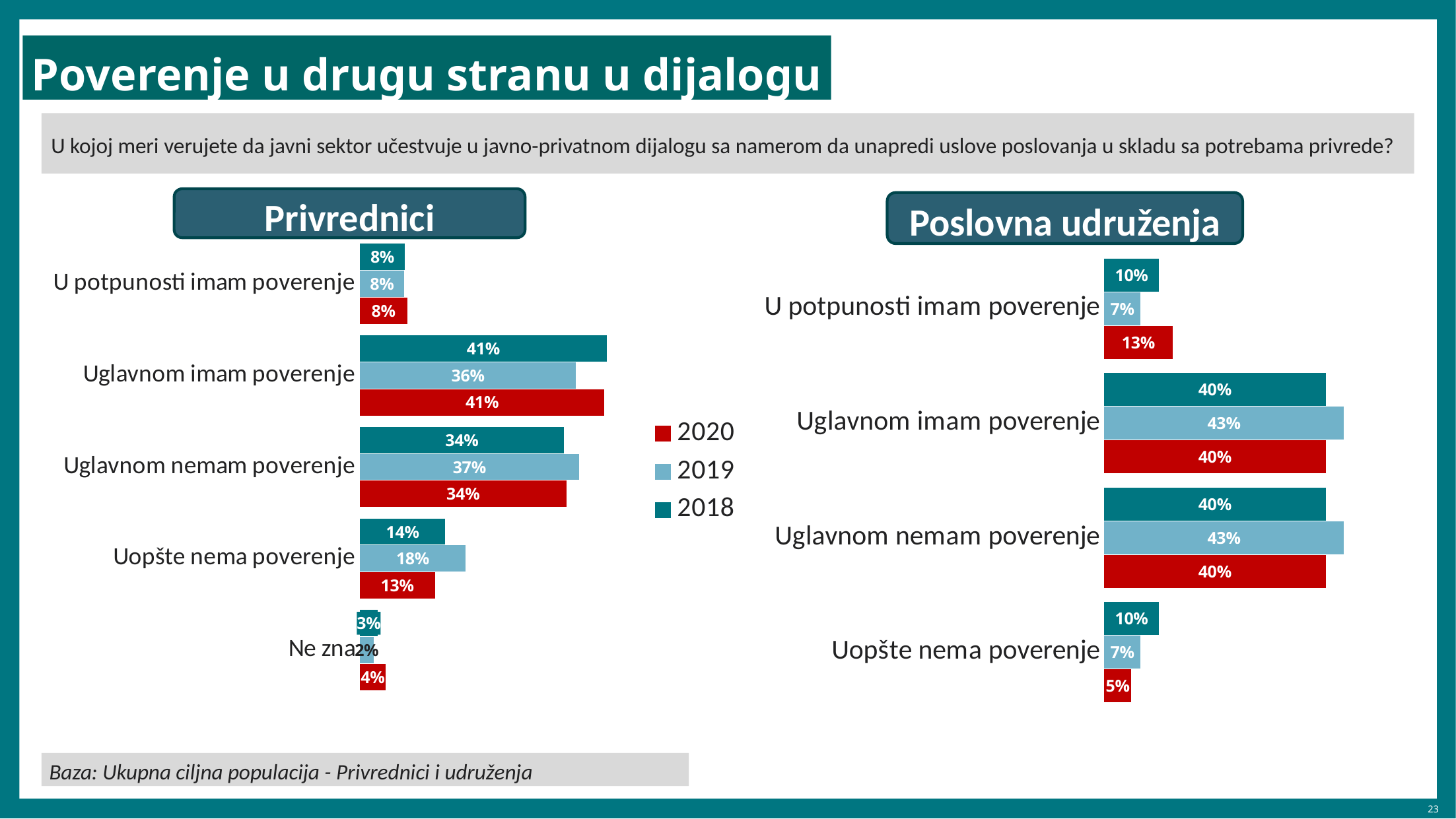
How many categories does the Poslovna udruženja chart show? 4 In the Poslovna udruženja chart, what is the 2019 value for "Uglavnom nemam poverenje"? 43% In the Privrednici chart, which category has the lowest 2019 value? Ne zna In the Poslovna udruženja chart, what is the 2020 value for "U potpunosti imam poverenje"? 13% In the Privrednici chart, what is the 2019 value for "Uglavnom imam poverenje"? 36% In the Privrednici chart, is the 2019 value for "Uglavnom nemam poverenje" larger or smaller than the 2018 value? larger What type of chart is the Privrednici chart? bar chart How many series does the legend list? 3 In the Privrednici chart, what is the 2020 value for "Uopšte nema poverenje"? 13% In the Poslovna udruženja chart, which category has the lowest 2020 value? Uopšte nema poverenje In the Privrednici chart, what is the difference between the 2019 and 2020 values for "Uopšte nema poverenje"? 5% In the Poslovna udruženja chart, what is the difference between the 2020 and 2019 values for "U potpunosti imam poverenje"? 6%